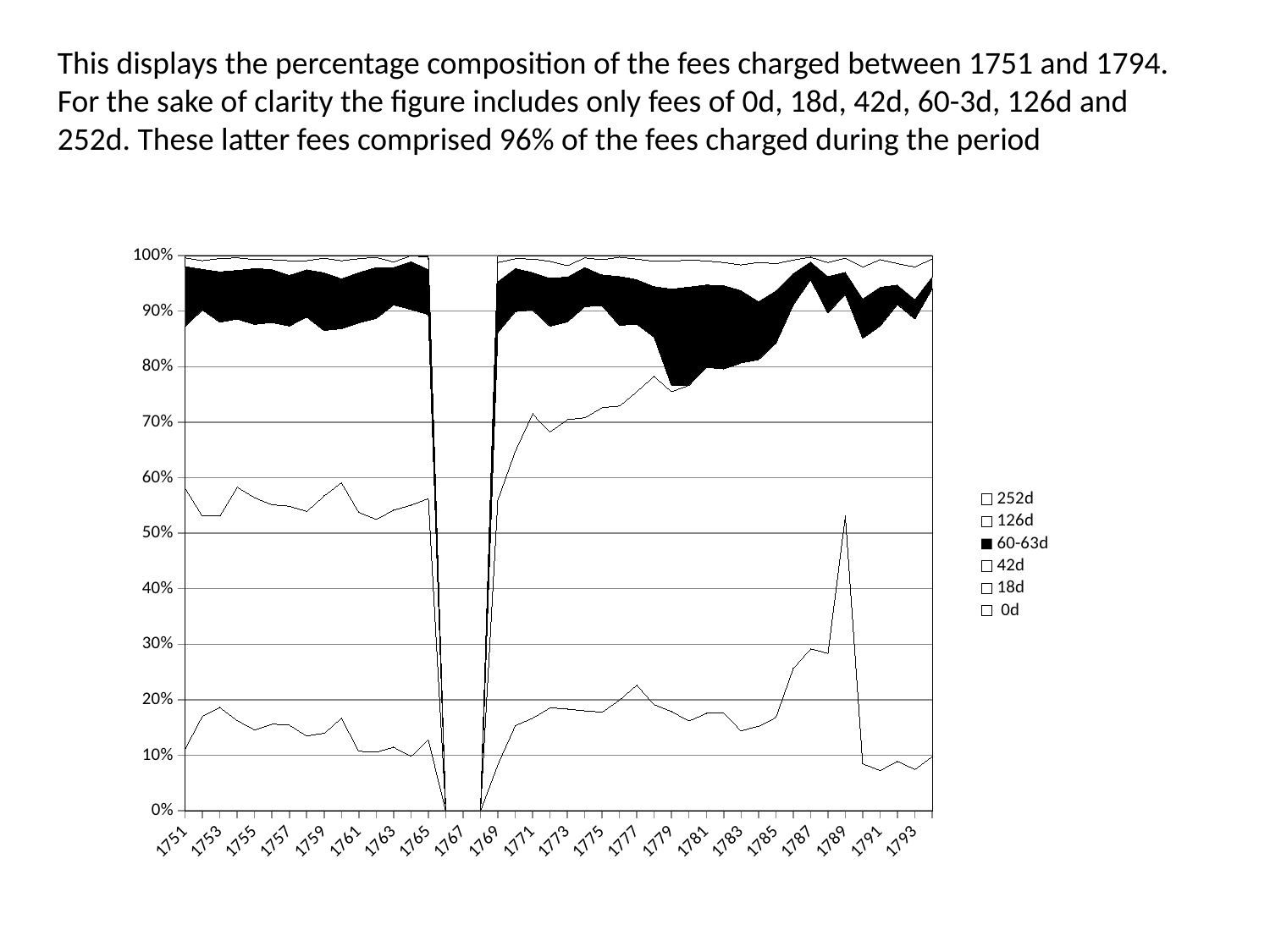
Is the share for 0d in 1789 greater or less than 50%? greater Does the share for 0d rise or fall between 1785 and 1789? rise Which series is drawn as a solid black area? 60-63d How many series does the legend list? 6 Is the share for 0d in 1791 greater or less than 10%? less Does the share for 0d rise or fall between 1789 and 1790? fall What kind of chart is shown on the slide? stacked area chart What is the first year label on the x axis? 1751 Is the share for 0d in 1753 greater or less than 10%? greater What is the highest value shown on the y axis? 100% In which year does the 0d share reach its highest point? 1789 How many year labels are printed along the x axis? 22